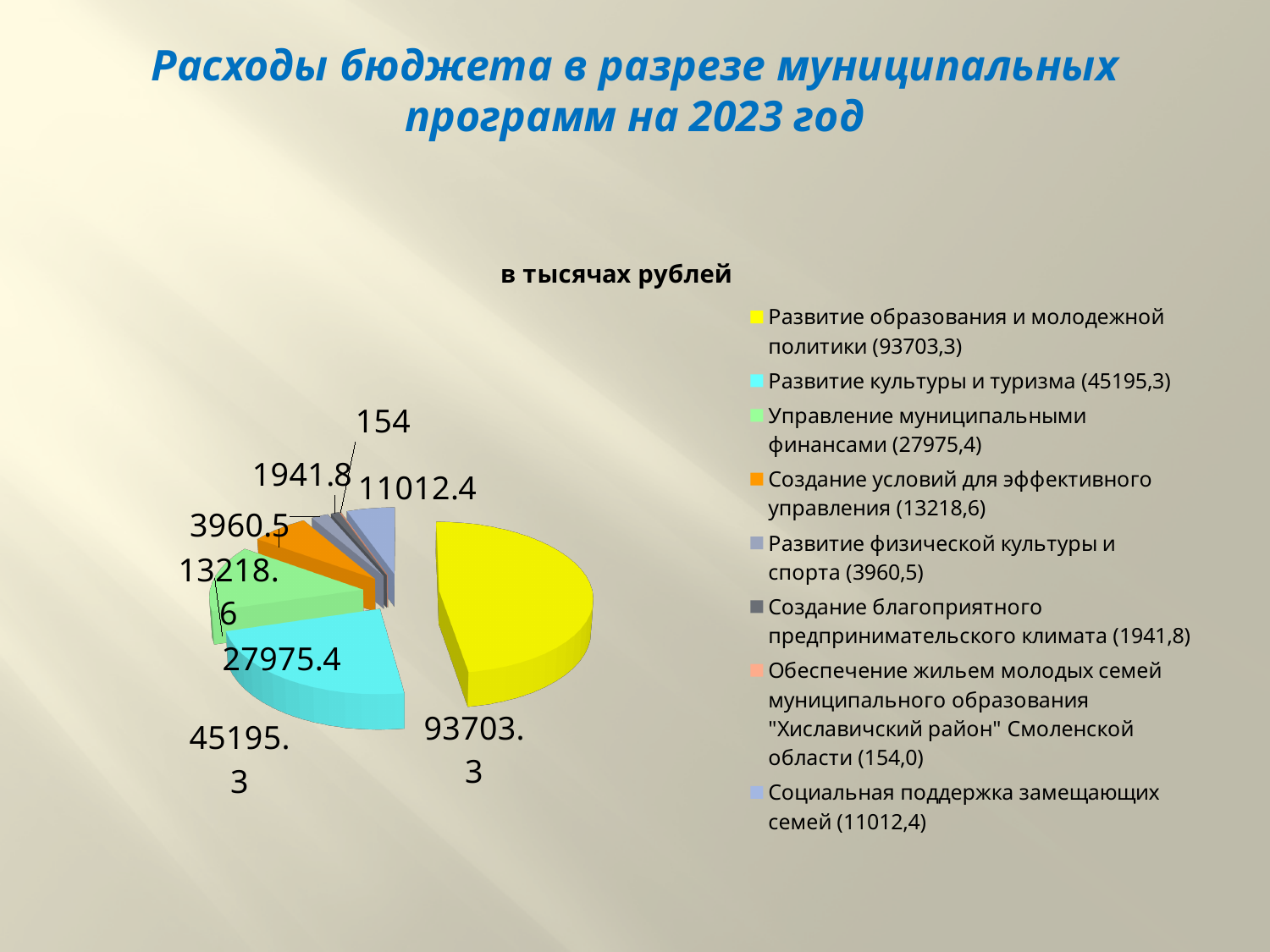
Which is larger: Управление муниципальными финансами or Создание условий для эффективного управления? Управление муниципальными финансами What is the value for Развитие культуры и туризма? 45195.3 What is the difference between the values for Развитие образования и молодежной политики and Развитие культуры и туризма? 48508 What kind of chart is shown on the slide? pie chart What is the value for Социальная поддержка замещающих семей? 11012.4 How many slices does the pie chart have? 8 What is the value for Создание благоприятного предпринимательского климата? 1941.8 What is the value for Развитие образования и молодежной политики? 93703.3 What unit is stated above the chart? в тысячах рублей Which program has the smallest share of the pie? Обеспечение жильем молодых семей муниципального образования "Хиславичский район" Смоленской области How many entries does the legend list? 8 Which program has the largest share of the pie? Развитие образования и молодежной политики